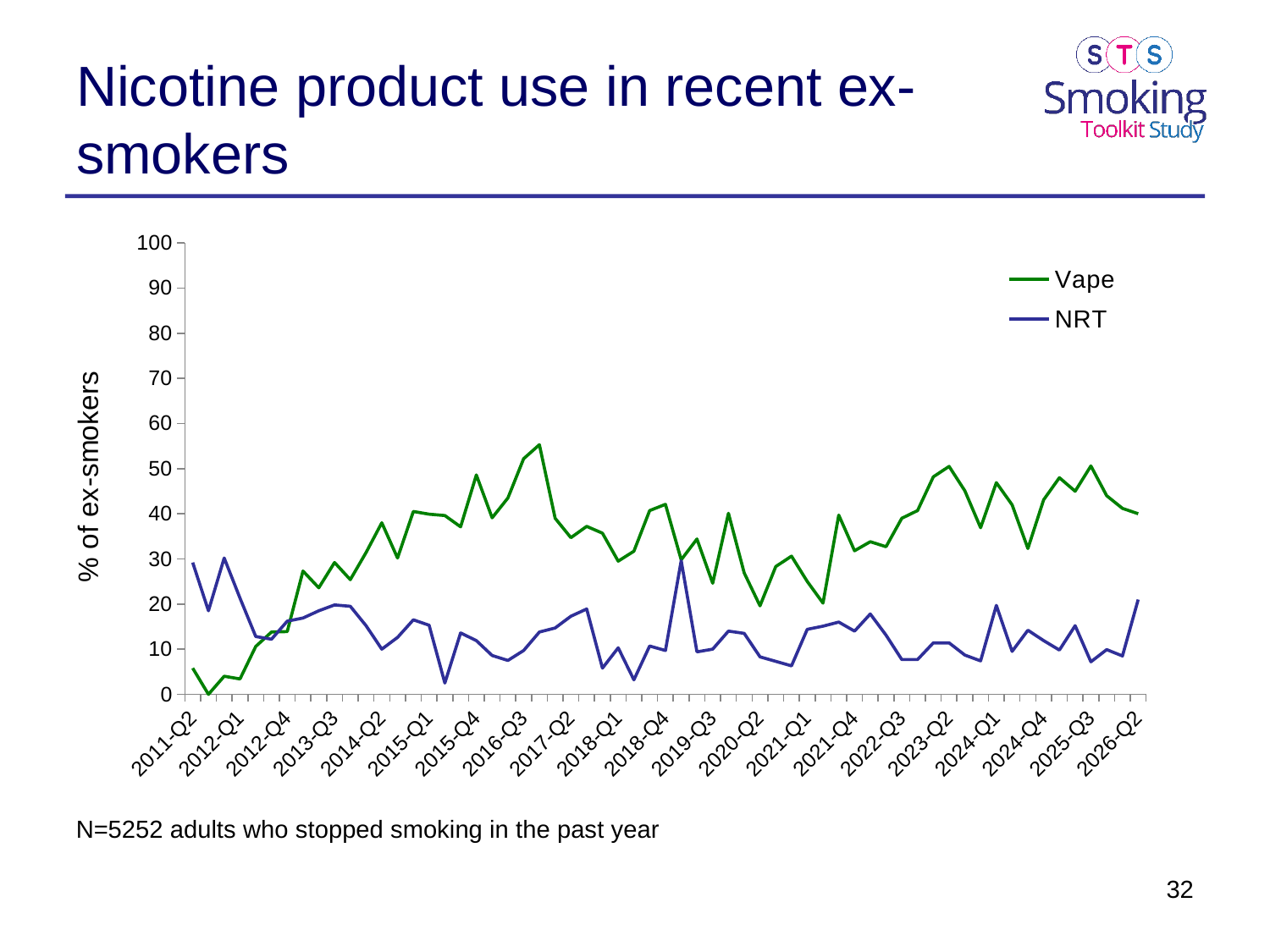
Is the value for NRT at 2011-Q2 greater or less than 20? greater What kind of chart is shown on the slide? Line chart What is the label on the y-axis of the chart? % of ex-smokers Which series reaches the highest value anywhere on the chart? Vape Does the Vape series overall rise or fall between 2011-Q2 and 2016-Q3? Rise How many series does the legend list? 2 Is the value for Vape at 2011-Q2 greater or less than 10? less At 2011-Q2, which series has the higher value, Vape or NRT? NRT Is the value for Vape at 2026-Q2 greater or less than 30? greater At 2026-Q2, which series has the higher value, Vape or NRT? Vape What are the two series named in the legend? Vape and NRT